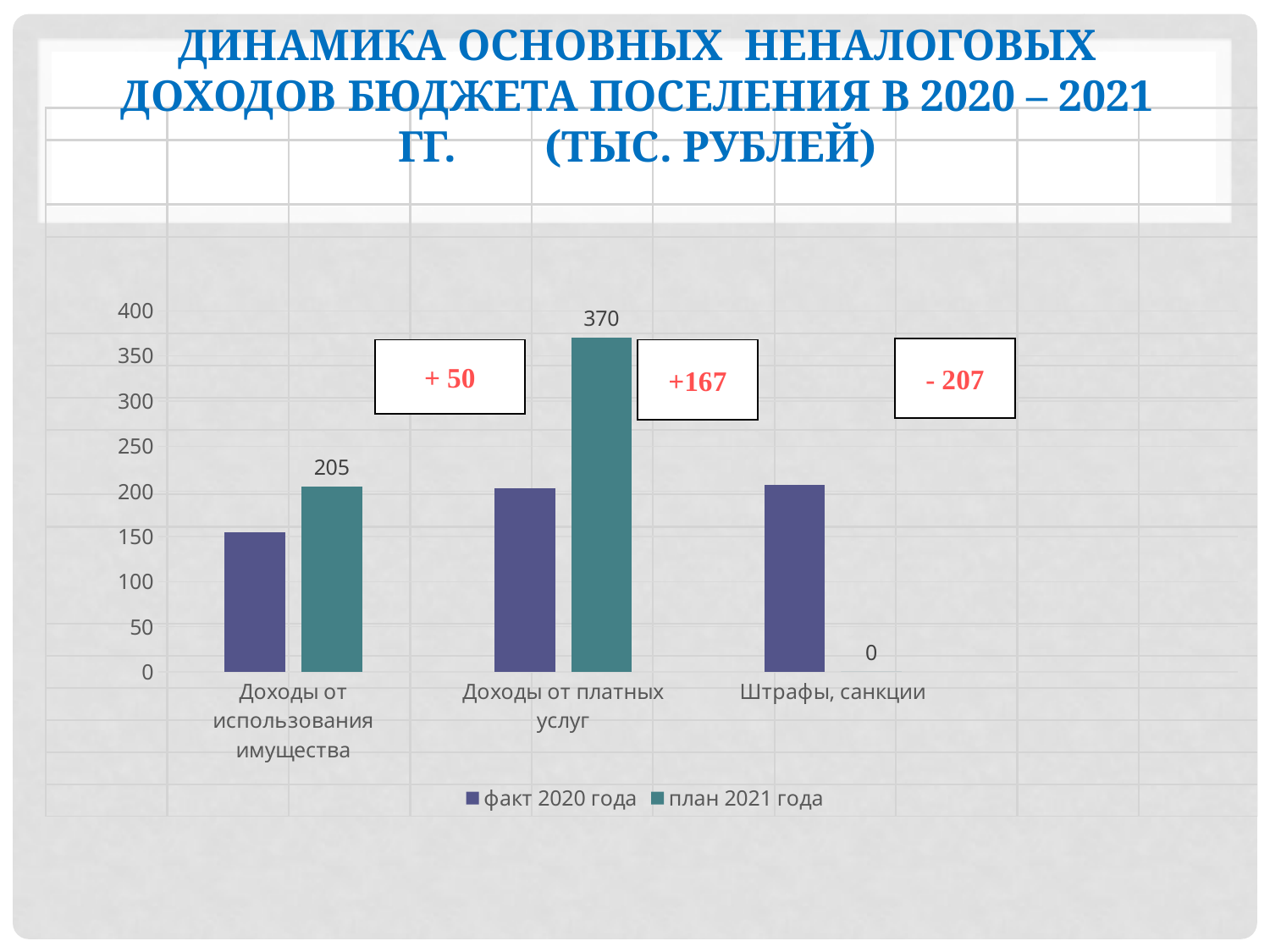
What is the value of план 2021 года for Доходы от использования имущества? 205 What kind of chart is shown on the slide? bar chart What is the difference between the план 2021 года values for Доходы от платных услуг and Доходы от использования имущества? 165 Is the факт 2020 года value for Штрафы, санкции greater or less than 150? greater What is the value of план 2021 года for Штрафы, санкции? 0 Which category has the lowest план 2021 года value? Штрафы, санкции What is the value of план 2021 года for Доходы от платных услуг? 370 How many categories are shown on the x axis? 3 Is the факт 2020 года value for Доходы от использования имущества greater or less than 200? less Which category has the highest план 2021 года value? Доходы от платных услуг How many series does the legend list? 2 For Доходы от платных услуг, which is larger: факт 2020 года or план 2021 года? план 2021 года